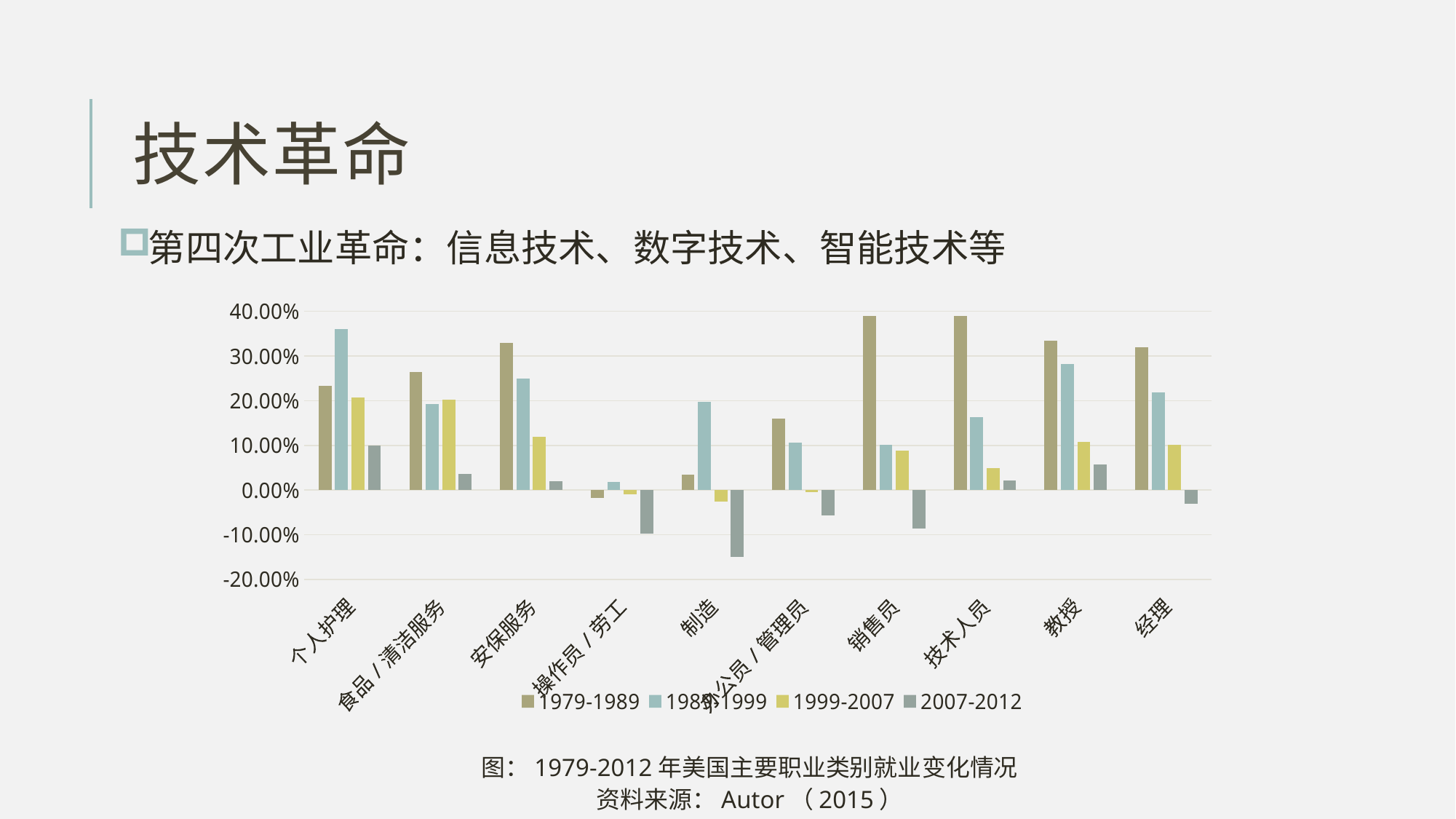
Which category has the lowest value in the 2007-2012 series? 制造 Is the 1989-1999 value for 个人护理 greater or less than 30.00%? greater Is the 1989-1999 value for 教授 greater or less than 20.00%? greater Which category has the highest value in the 2007-2012 series? 个人护理 How many occupation categories are shown on the x axis of the chart? 10 Which category has the lowest value in the 1979-1989 series? 操作员 / 劳工 Is the 2007-2012 value for 制造 greater or less than -10.00%? less How many series does the chart's legend list? 4 Which category has the highest value in the 1989-1999 series? 个人护理 What kind of chart is shown on the slide? bar chart For 安保服务, which is larger: the 1979-1989 value or the 1989-1999 value? 1979-1989